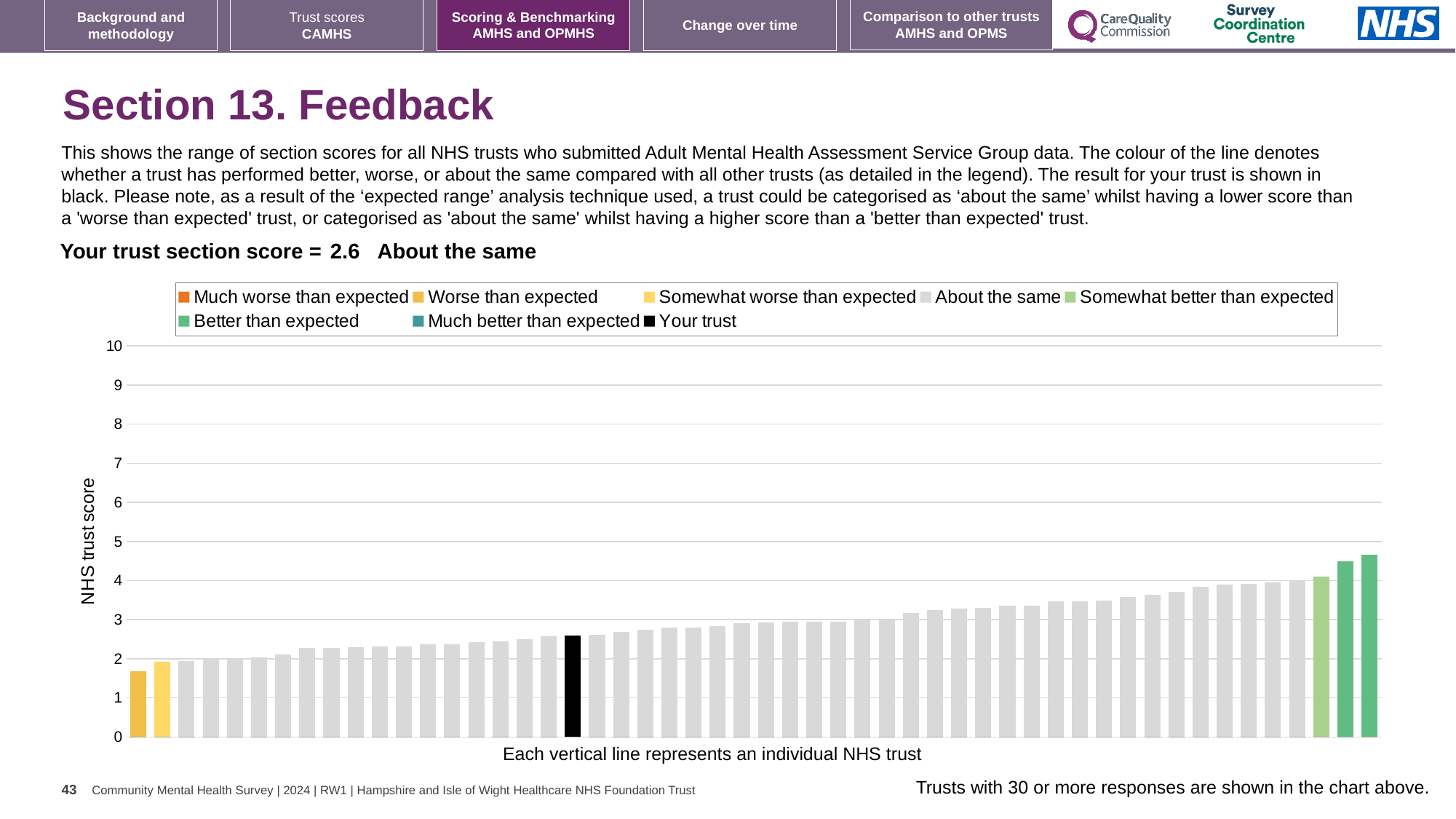
Which legend category do the tallest bars on the right of the chart belong to? Better than expected How many bars are coloured green (somewhat better or better than expected) in the chart? 3 What colour is used for the 'Your trust' bar in the chart? black Is the value of the leftmost bar in the chart greater or less than 2? less Is the value of the tallest bar in the chart greater or less than 4? greater Do the bar values rise or fall from left to right along the x axis? rise Is the value of the black 'Your trust' bar greater or less than 3? less Which category is your trust's section score placed in? About the same What is the section score for your trust? 2.6 How many entries does the chart legend list? 8 What kind of chart is shown on the slide? bar chart What is the label on the vertical axis of the chart? NHS trust score